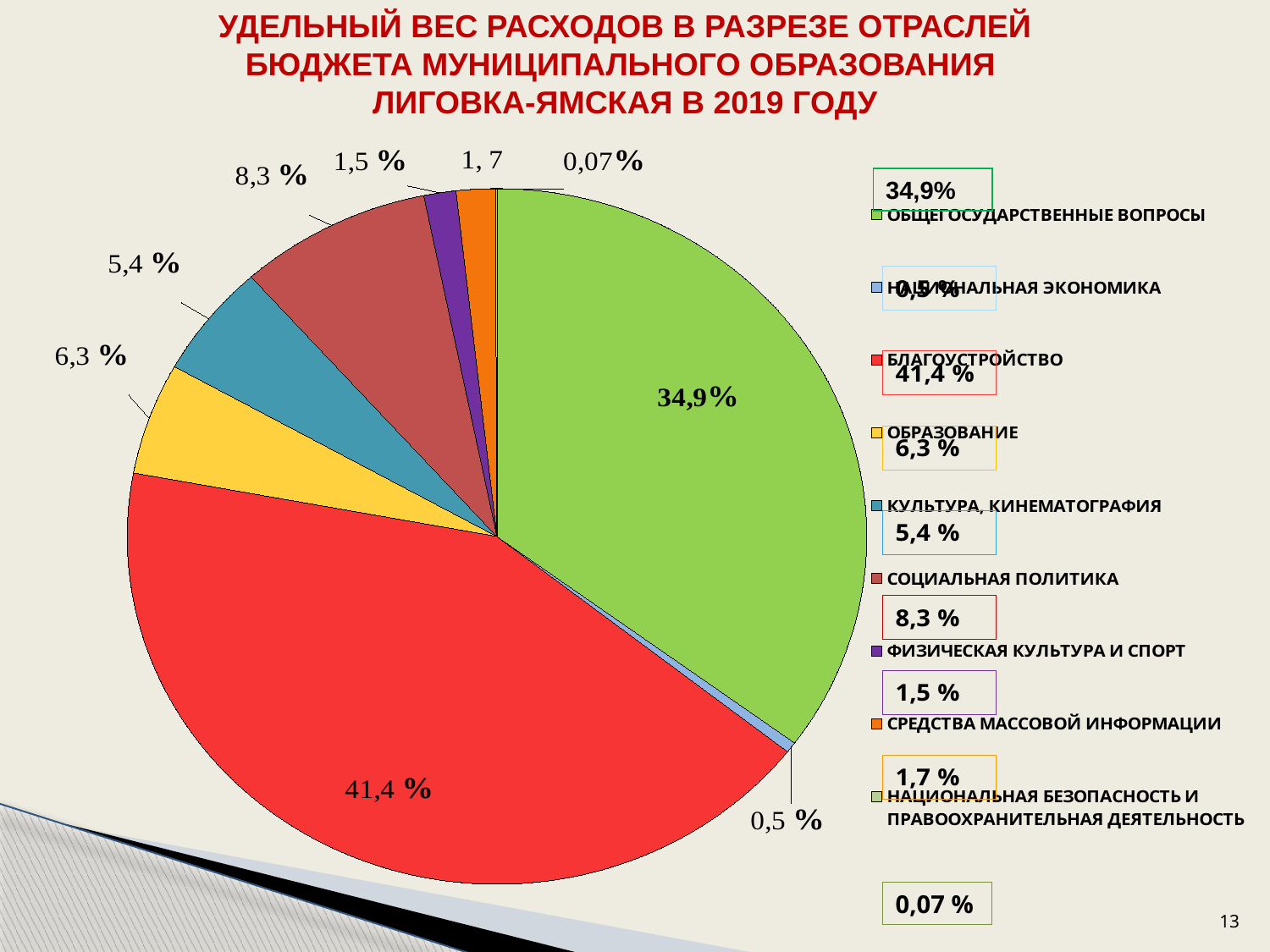
By how many percentage points does БЛАГОУСТРОЙСТВО exceed ОБЩЕГОСУДАРСТВЕННЫЕ ВОПРОСЫ? 6,5 % What is the value shown for КУЛЬТУРА, КИНЕМАТОГРАФИЯ? 5,4 % Which category has the largest share of expenditures? БЛАГОУСТРОЙСТВО Which category has the smallest share of expenditures? НАЦИОНАЛЬНАЯ БЕЗОПАСНОСТЬ И ПРАВООХРАНИТЕЛЬНАЯ ДЕЯТЕЛЬНОСТЬ How many categories does the legend list? 9 Which is larger: the share for СОЦИАЛЬНАЯ ПОЛИТИКА or for ОБРАЗОВАНИЕ? СОЦИАЛЬНАЯ ПОЛИТИКА What type of chart is shown on the slide? pie chart What is the value shown for НАЦИОНАЛЬНАЯ БЕЗОПАСНОСТЬ И ПРАВООХРАНИТЕЛЬНАЯ ДЕЯТЕЛЬНОСТЬ? 0,07 % What is the value shown for ОБРАЗОВАНИЕ? 6,3 % What share of expenditures does БЛАГОУСТРОЙСТВО account for? 41,4 % What share of expenditures does ОБЩЕГОСУДАРСТВЕННЫЕ ВОПРОСЫ account for? 34,9% What is the value shown for СОЦИАЛЬНАЯ ПОЛИТИКА? 8,3 %